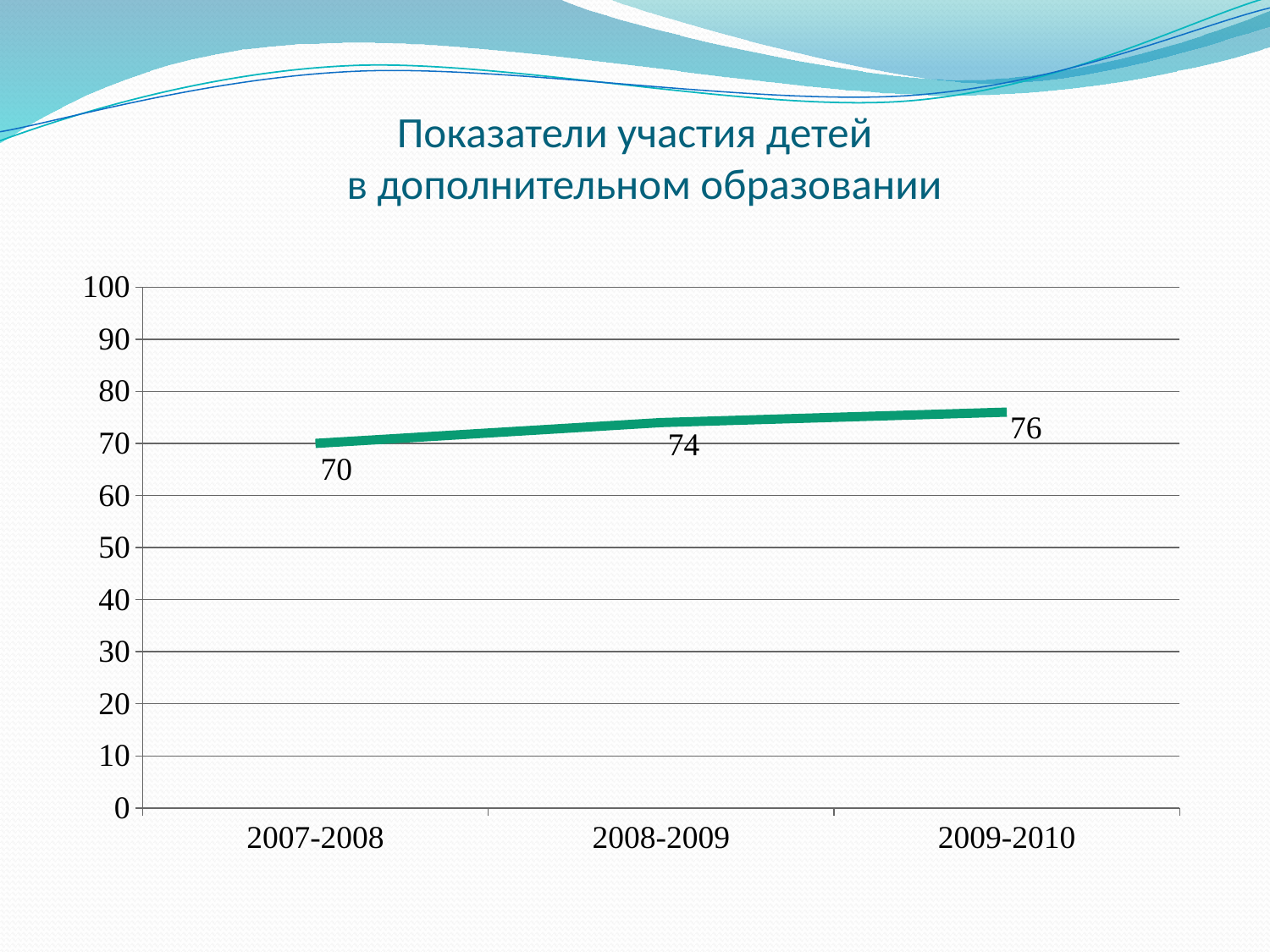
Which period has the lowest value? 2007-2008 Is the value for 2009-2010 greater or less than 80? less Which period has the highest value? 2009-2010 What kind of chart is shown on the slide? line chart What is the value for 2009-2010? 76 What is the value for 2008-2009? 74 What is the difference between the values for 2009-2010 and 2007-2008? 6 Which is larger, the value for 2008-2009 or the value for 2009-2010? 2009-2010 Do the values rise or fall from 2007-2008 to 2009-2010? rise What is the difference between the values for 2008-2009 and 2007-2008? 4 What is the value for 2007-2008? 70 How many periods are shown on the x axis? 3